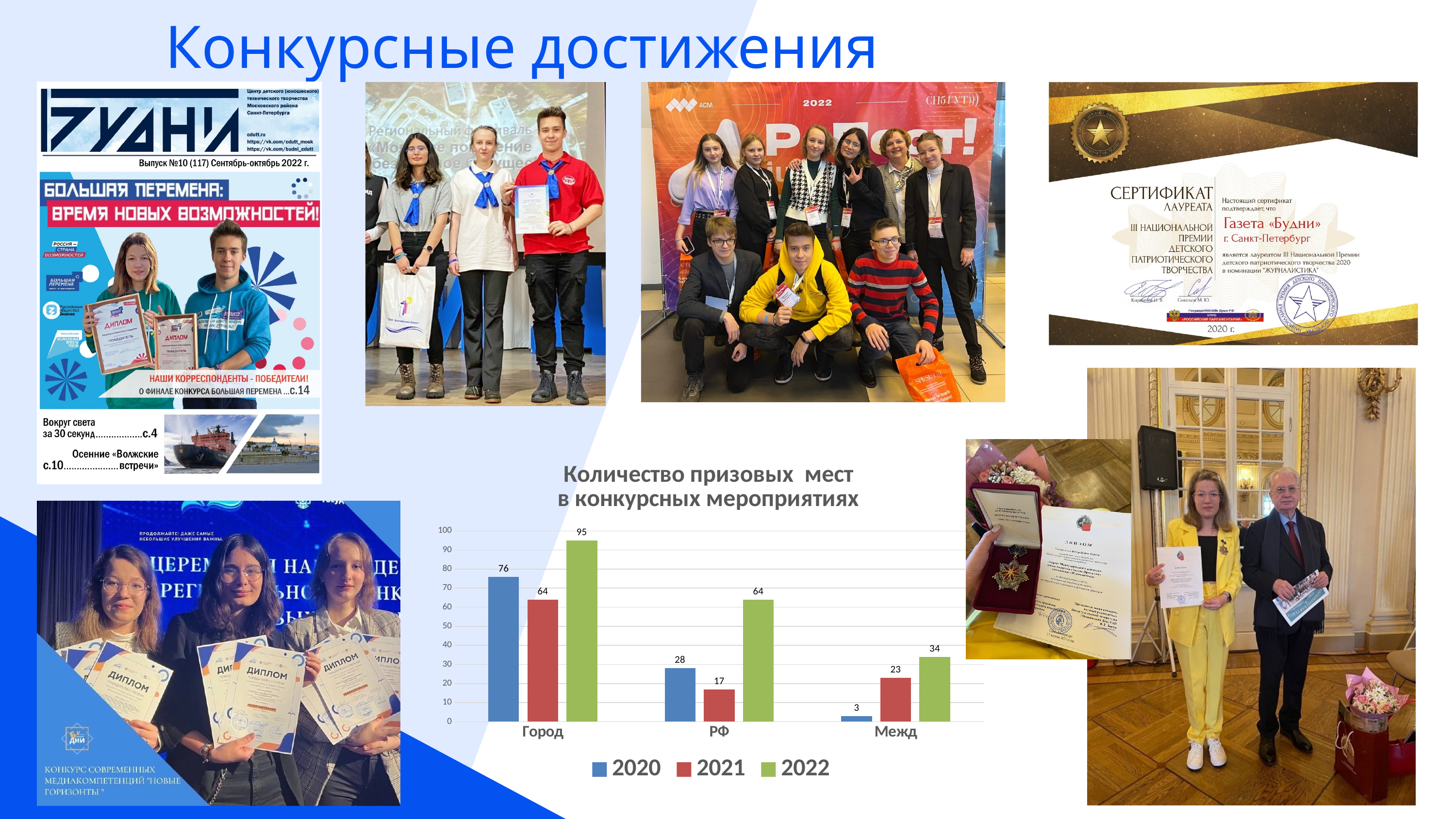
Do the values for the 2020 series rise or fall from Город to Межд? fall What is the difference between the 2022 and 2021 values in the РФ category? 47 Which category has the highest value for the 2020 series? Город What is the value for 2020 in the РФ category? 28 How many categories are shown on the x axis of the chart? 3 Which category has the lowest value for the 2022 series? Межд What is the value for 2021 in the Межд category? 23 How many series does the chart legend list? 3 Which is larger in the Город category: the 2020 value or the 2021 value? 2020 What kind of chart is shown on the slide? bar chart What is the title of the chart? Количество призовых мест в конкурсных мероприятиях What is the value for 2022 in the Город category? 95